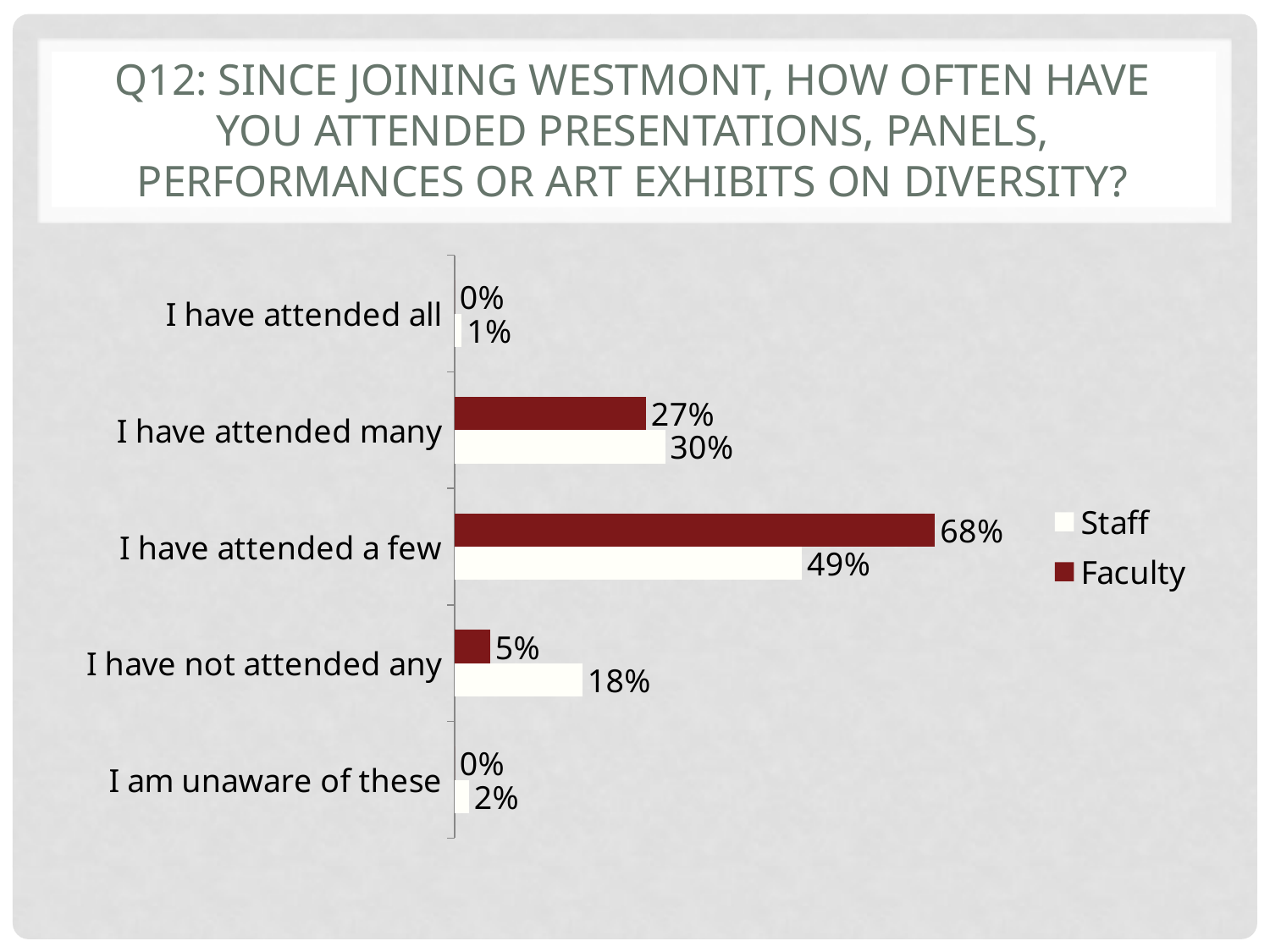
What percentage of Staff said they have attended a few? 49% Which category has the highest value for Faculty? I have attended a few What percentage of Faculty said they have attended many? 27% How many series does the legend list? 2 What percentage of Staff said they have not attended any? 18% What is the difference between the Faculty and Staff values for 'I have attended a few'? 19% What percentage of Faculty said they have attended a few? 68% For 'I have attended many', which group has the larger value, Staff or Faculty? Staff What kind of chart is shown on the slide? Bar chart What is the difference between the Staff and Faculty values for 'I have not attended any'? 13% How many response categories are shown on the chart? 5 Which category has the lowest value for Staff? I have attended all